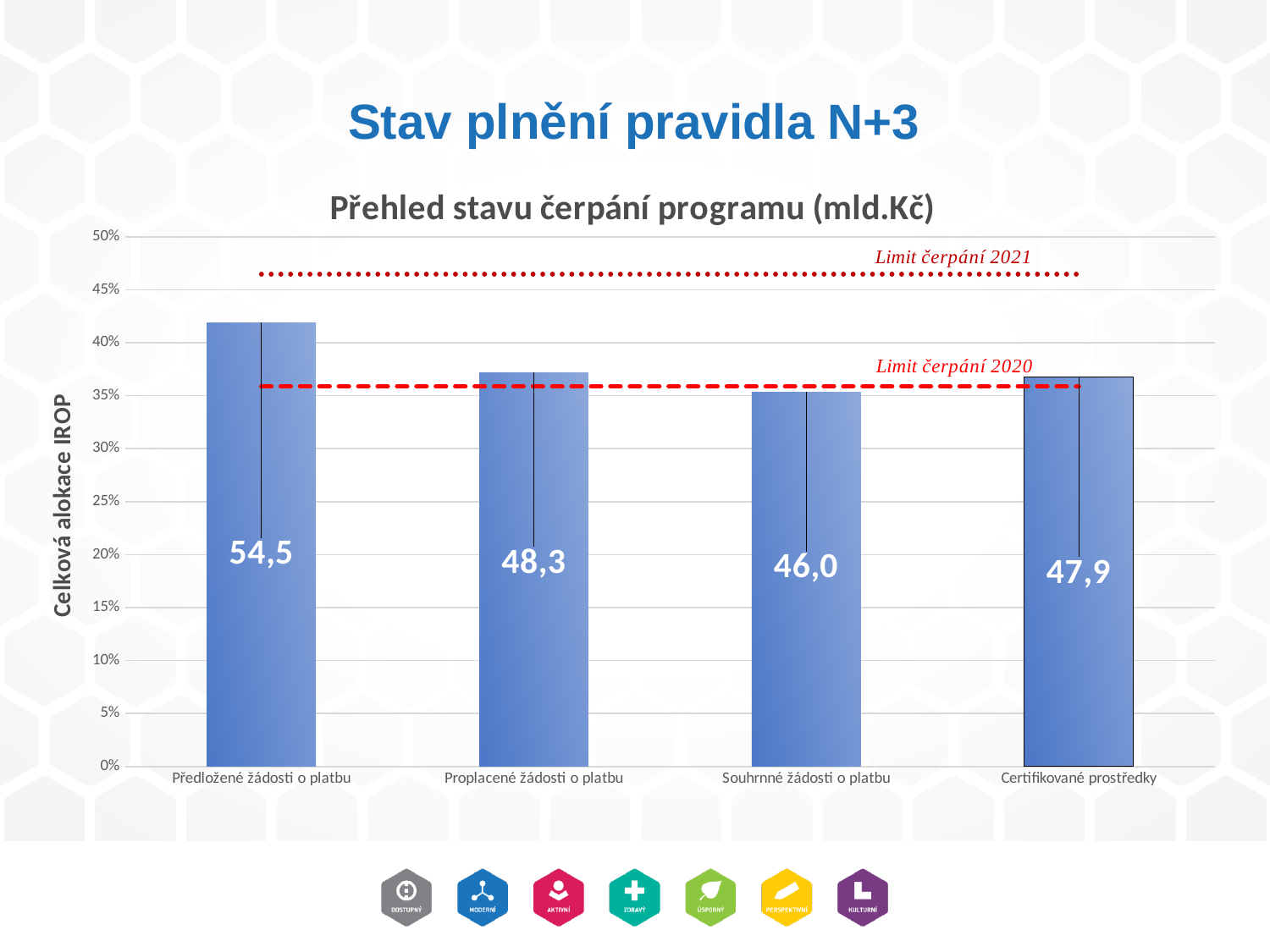
What is the data label on the bar for Proplacené žádosti o platbu? 48,3 Which category has the lowest bar? Souhrnné žádosti o platbu What is the difference between the data labels for Předložené žádosti o platbu and Souhrnné žádosti o platbu? 8,5 Which category has the highest bar? Předložené žádosti o platbu What kind of chart is shown on the slide? bar chart Is the bar for Předložené žádosti o platbu greater or less than 40% on the y axis? greater What is the title of the chart? Přehled stavu čerpání programu (mld.Kč) What is the data label on the bar for Souhrnné žádosti o platbu? 46,0 What is the data label on the bar for Certifikované prostředky? 47,9 Which is larger, the value for Certifikované prostředky or the value for Souhrnné žádosti o platbu? Certifikované prostředky What is the data label on the bar for Předložené žádosti o platbu? 54,5 How many categories are shown on the x axis? 4